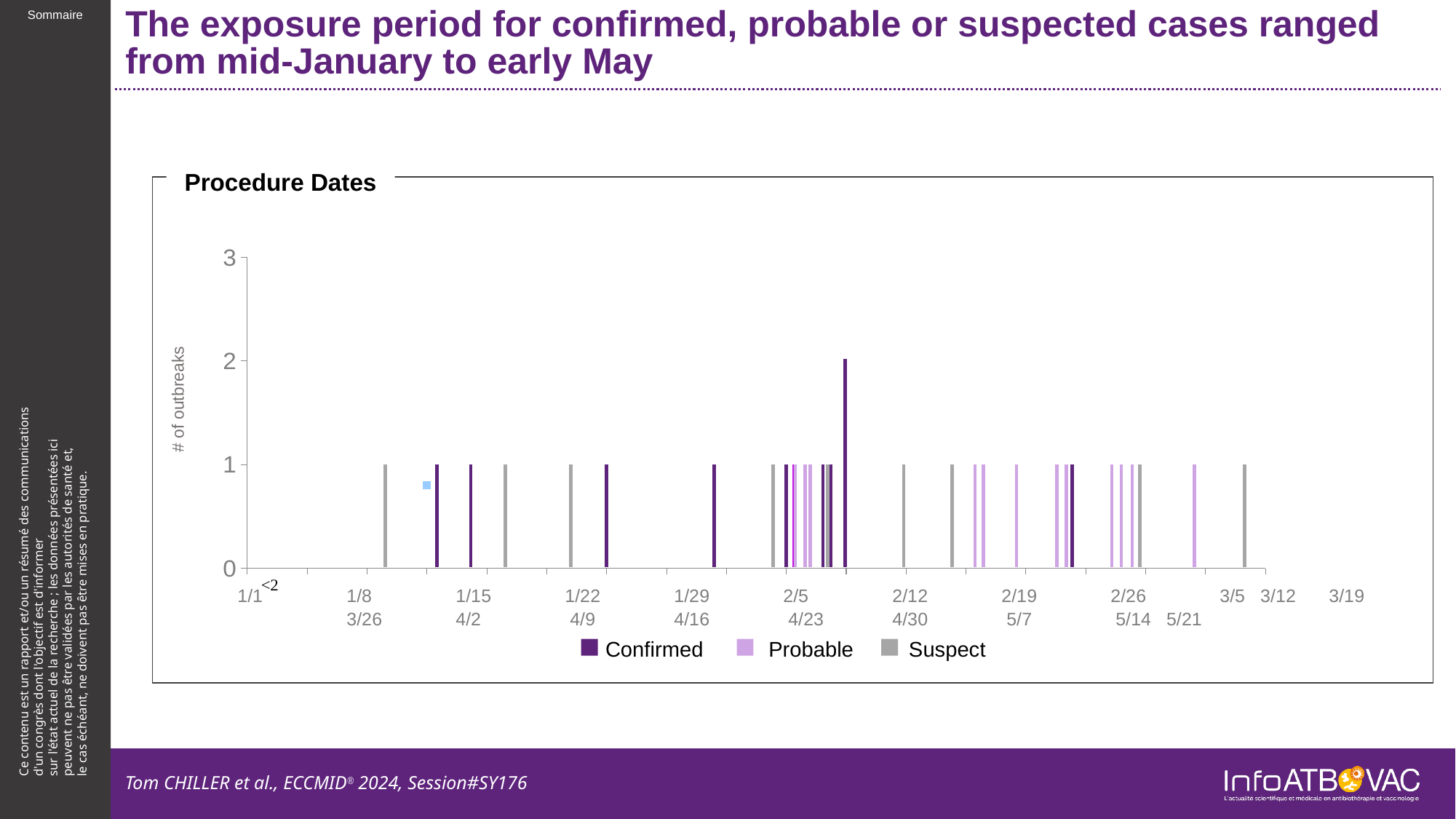
What kind of chart is shown under the title "Procedure Dates"? bar chart How many series does the legend of the "Procedure Dates" chart list? 3 What is the title of the chart on the slide? Procedure Dates Which series does the tallest bar in the "Procedure Dates" chart belong to? Confirmed What is the highest tick value shown on the vertical axis of the "Procedure Dates" chart? 3 What is the label of the vertical axis of the "Procedure Dates" chart? # of outbreaks What is the highest value reached by any bar in the "Procedure Dates" chart? 2 Is the tallest bar in the "Procedure Dates" chart greater or less than 3? less In the "Procedure Dates" chart, what value do all bars other than the tallest one reach? 1 What is the difference between the tallest bar and the other bars in the "Procedure Dates" chart? 1